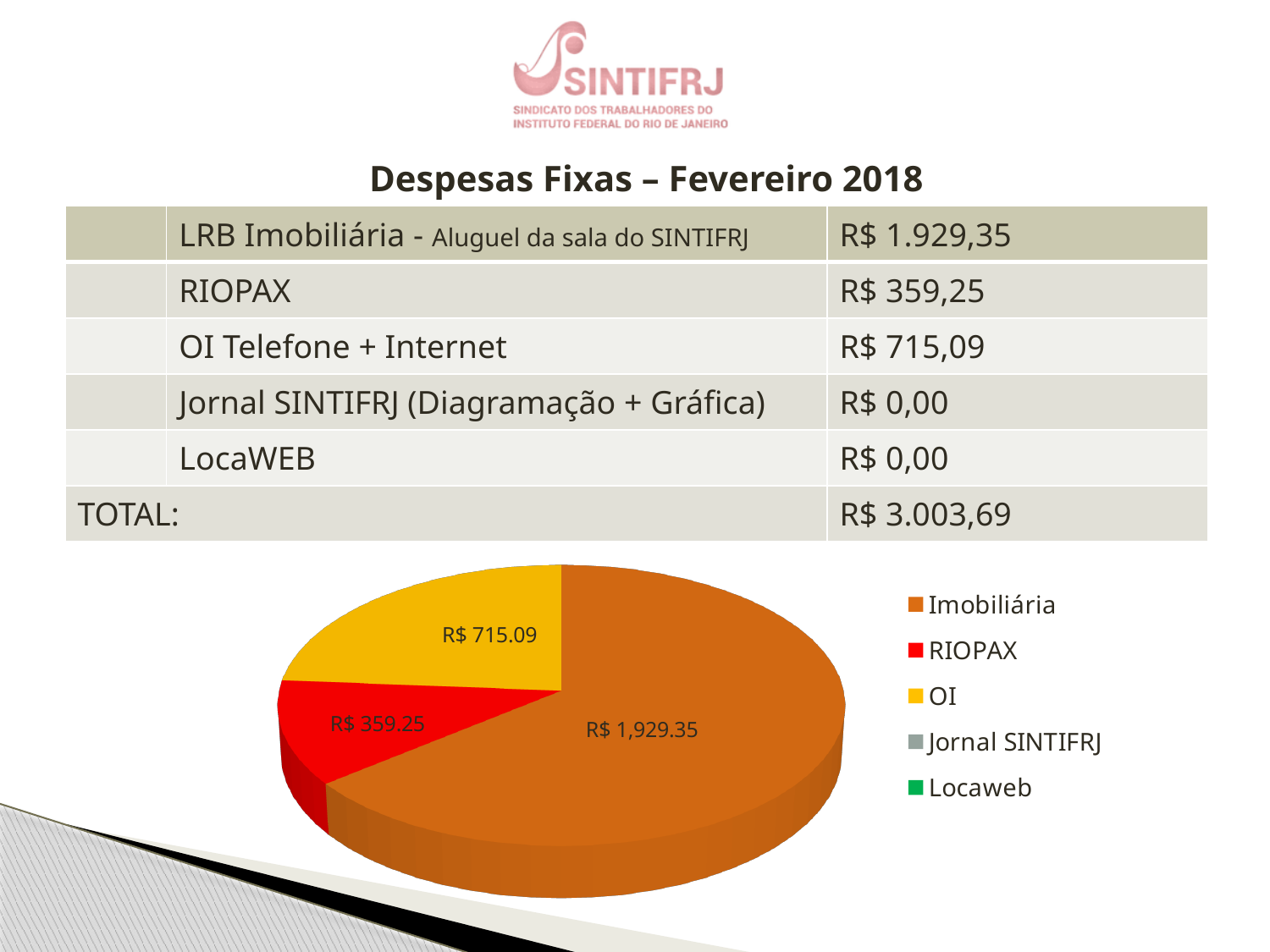
How many slices with data labels are visible in the pie chart? 3 What is the value shown for the RIOPAX slice of the pie chart? R$ 359.25 Does the Imobiliária slice take up more or less than half of the pie chart? More than half Which category has the largest slice in the pie chart? Imobiliária What is the difference between the OI value and the RIOPAX value in the pie chart? R$ 355.84 What is the value shown for the Imobiliária slice of the pie chart? R$ 1,929.35 Which slice is larger in the pie chart, OI or RIOPAX? OI What is the difference between the Imobiliária value and the OI value in the pie chart? R$ 1,214.26 What is the value shown for the OI slice of the pie chart? R$ 715.09 What type of chart is shown on the slide? Pie chart How many entries does the legend of the pie chart list? 5 What colour is the RIOPAX slice in the pie chart? Red